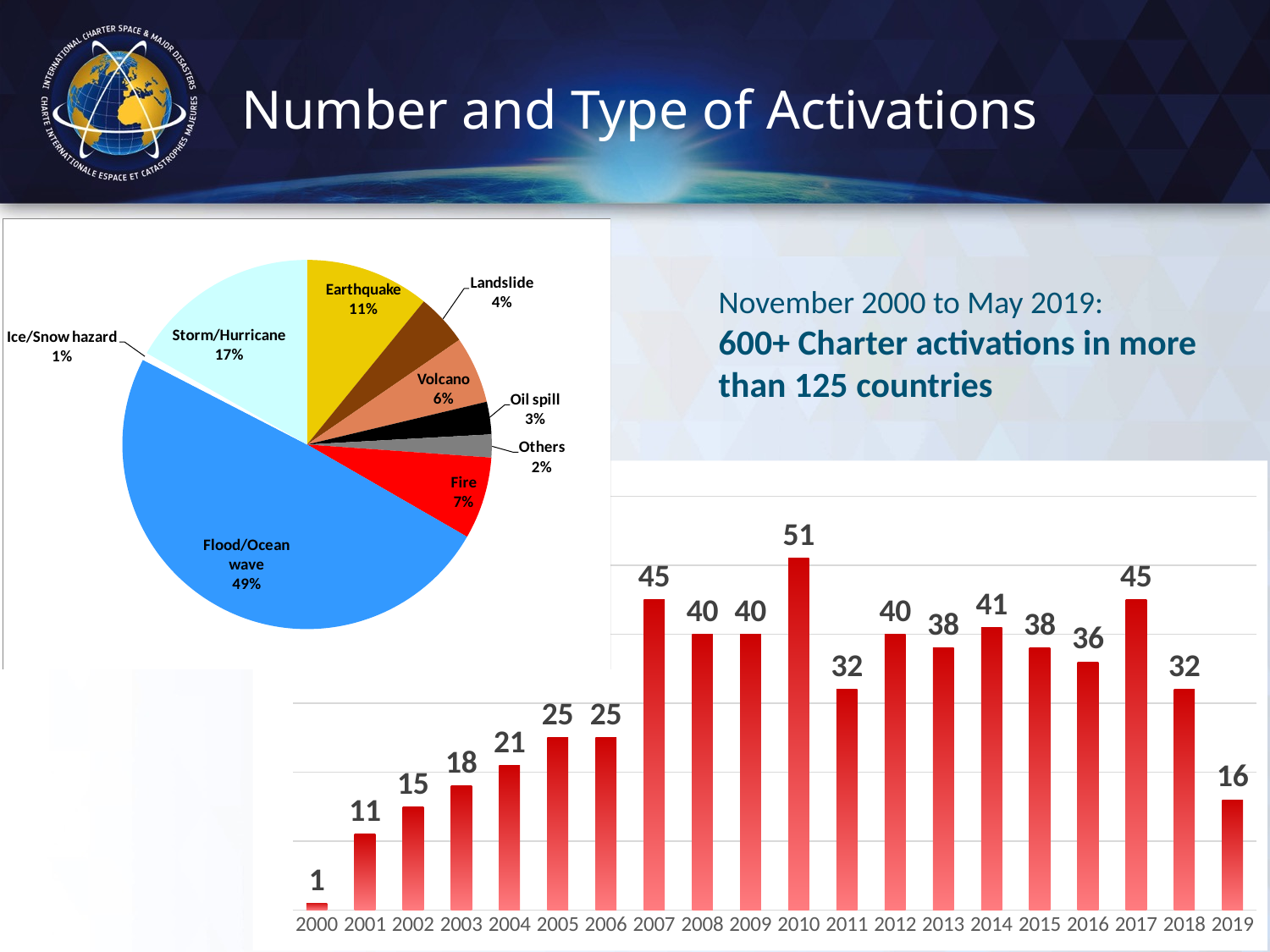
In the bar chart, which year had more activations, 2014 or 2016? 2014 In the bar chart, which year has the highest number of activations? 2010 In the pie chart, how many categories are shown? 9 In the bar chart, do the values rise or fall from 2000 to 2007? rise What kind of chart is the chart at the bottom right of the slide? bar chart In the pie chart, what is the difference between the Storm/Hurricane share and the Earthquake share? 6% In the pie chart, what share of activations is Flood/Ocean wave? 49% In the bar chart, what is the difference between the number of activations in 2017 and in 2018? 13 In the bar chart, how many activations were there in 2010? 51 In the bar chart, how many years are shown on the x axis? 20 In the bar chart, which year has the lowest number of activations? 2000 In the pie chart, which category has the smallest share? Ice/Snow hazard